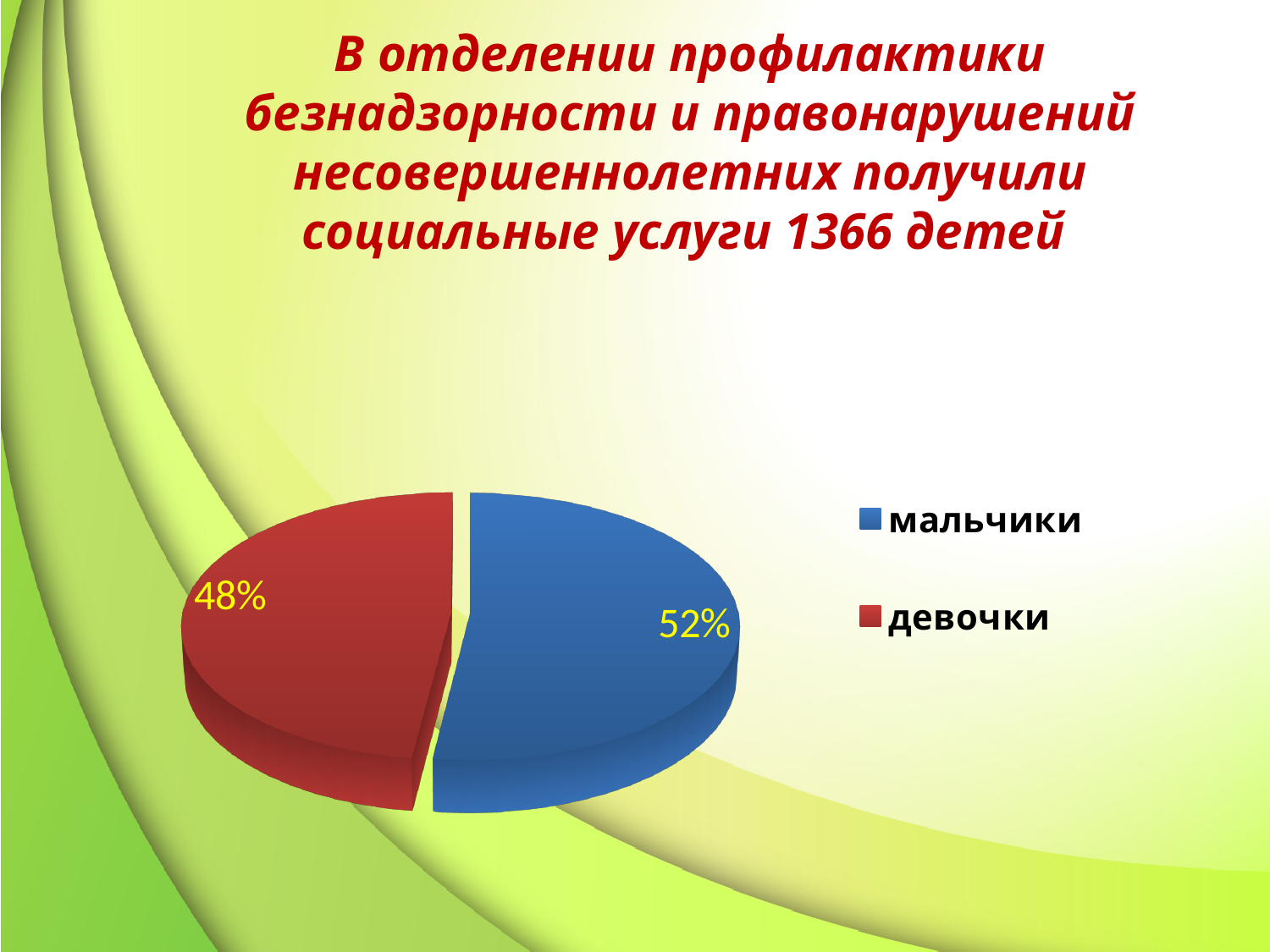
Which category has the larger slice of the pie? мальчики What kind of chart is shown on the slide? pie chart Which slice is larger, мальчики or девочки? мальчики What colour is the slice for мальчики? blue Is the share for мальчики greater or less than 50%? greater What is the difference in percentage points between the мальчики and девочки slices? 4% What share of the pie is labelled девочки? 48% Which category has the smaller slice of the pie? девочки How many slices does the pie chart have? 2 How many entries does the legend list? 2 What share of the pie is labelled мальчики? 52% What colour is the slice for девочки? red